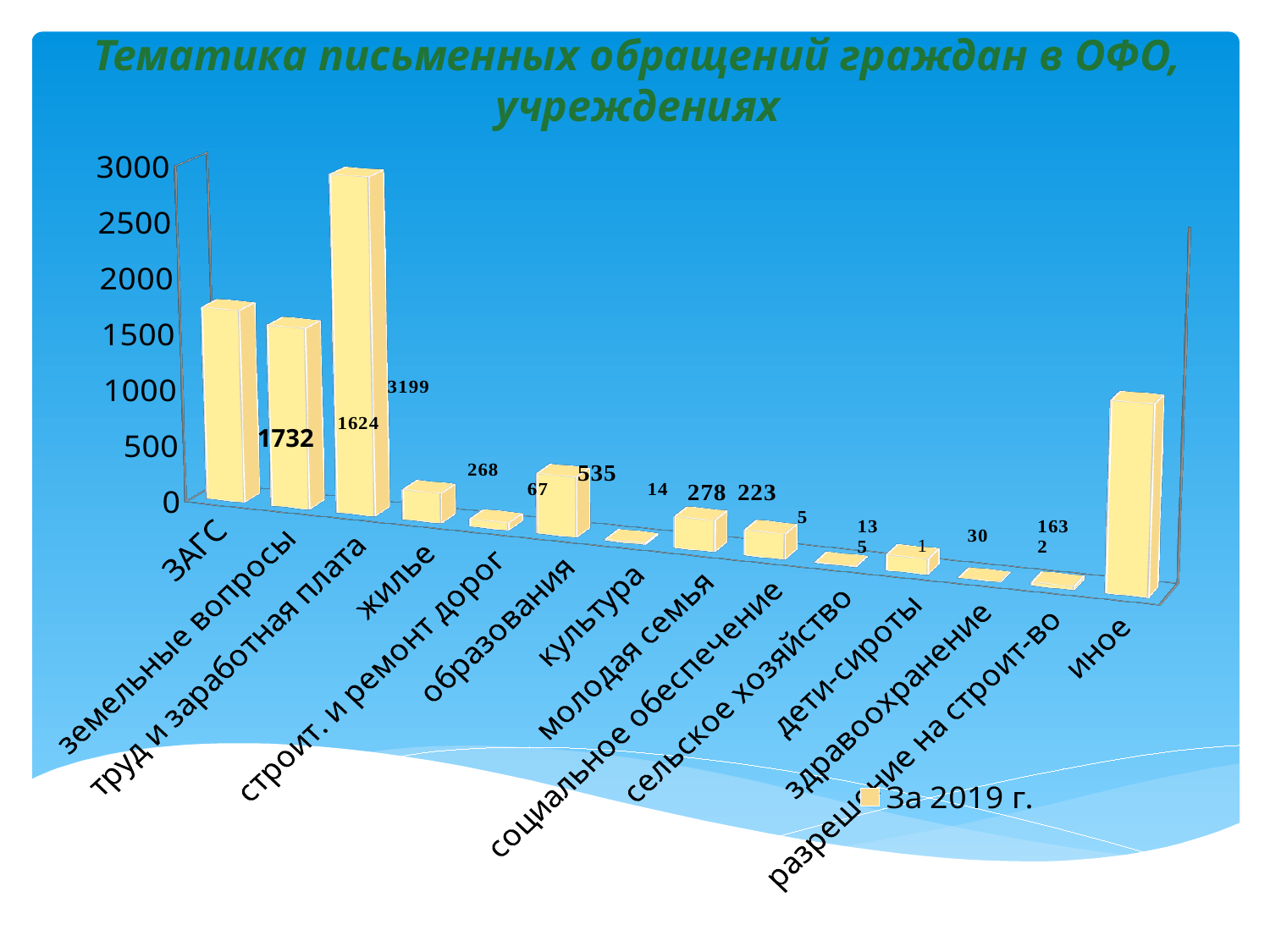
How many series does the legend list? 1 Which category has the highest value in the chart? труд и заработная плата What is the value for образования? 535 What type of chart is shown on the slide? bar chart What is the legend entry for the series in the chart? За 2019 г. What is the difference between the values for труд и заработная плата and ЗАГС? 1467 What is the value for ЗАГС? 1732 What is the value for молодая семья? 278 How many categories are shown on the x axis of the chart? 14 Which is larger, the value for ЗАГС or the value for земельные вопросы? ЗАГС Is the value for иное greater or less than 500? greater What is the value for труд и заработная плата? 3199